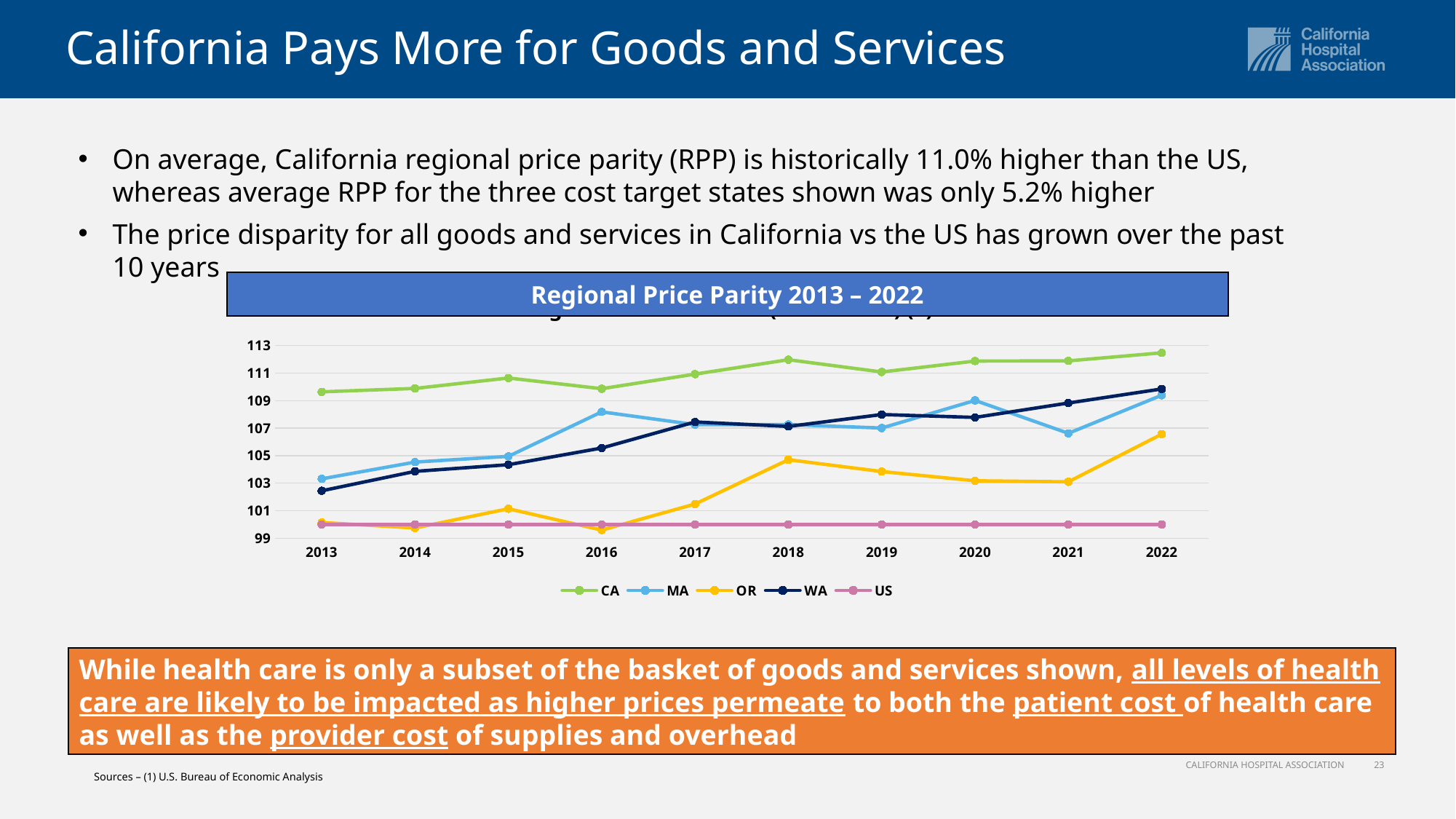
What is the title of the chart? Regional Price Parity 2013 – 2022 Is the value for WA in 2013 greater or less than 103? less Is the value for OR in 2018 greater or less than 103? greater Which series has the lowest value in 2016? OR What kind of chart is shown on the slide? Line chart Is the value for MA in 2016 greater or less than 107? greater Which series has the highest value in 2022? CA Does the US series rise, fall, or stay flat from 2013 to 2022? Stays flat How many years are plotted along the x axis of the chart? 10 In 2016, which is larger, the value for MA or the value for WA? MA How many series does the legend of the Regional Price Parity chart list? 5